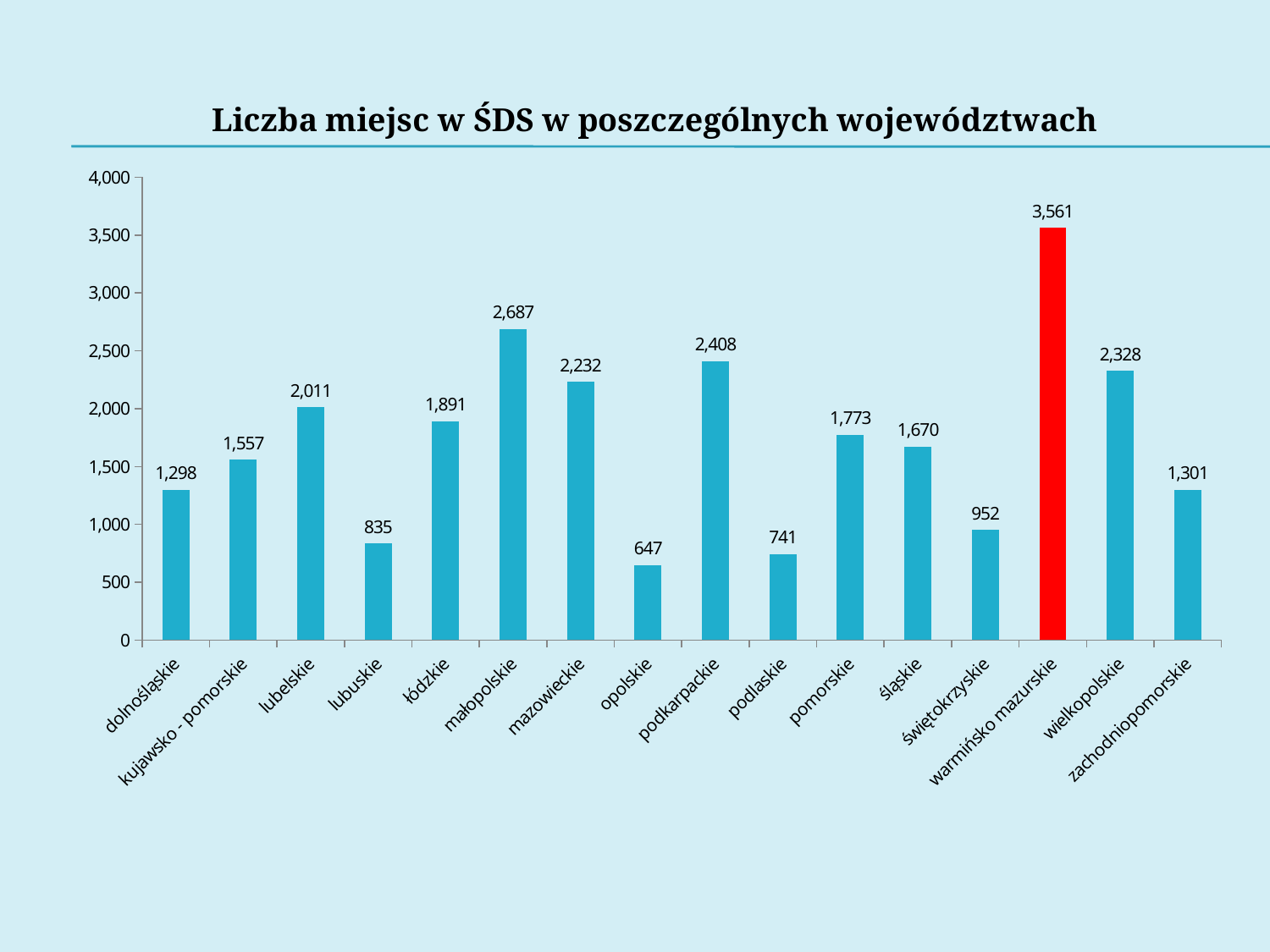
Which voivodeship has the lowest value? opolskie What is the difference between the values for warmińsko mazurskie and małopolskie? 874 What is the title of the chart? Liczba miejsc w ŚDS w poszczególnych województwach Which voivodeship has the highest value? warmińsko mazurskie What is the value for warmińsko mazurskie? 3,561 Which is larger, the value for podkarpackie or the value for wielkopolskie? podkarpackie Is the value for lubuskie greater or less than 1,000? less What is the value for małopolskie? 2,687 How many voivodeships are shown on the x axis? 16 What is the value for opolskie? 647 What kind of chart is shown on the slide? bar chart Which bar is coloured red instead of blue? warmińsko mazurskie